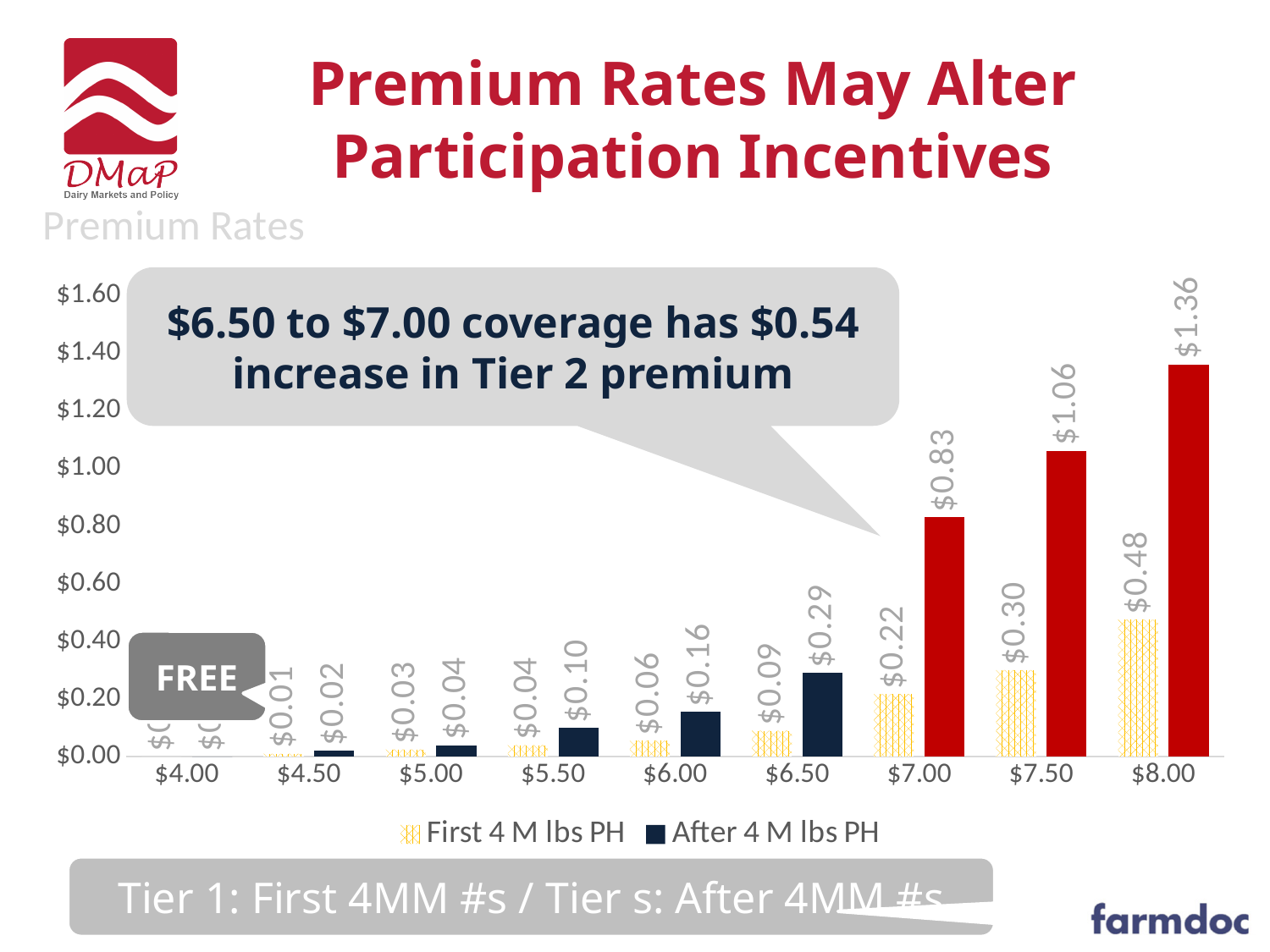
Which is larger at the $7.50 coverage level: First 4 M lbs PH or After 4 M lbs PH? After 4 M lbs PH How many coverage levels are shown on the x axis? 9 What is the value for First 4 M lbs PH at the $7.00 coverage level? $0.22 What is the value for After 4 M lbs PH at the $6.50 coverage level? $0.29 What is the difference between the After 4 M lbs PH premium at $7.00 and at $6.50? $0.54 Do the After 4 M lbs PH premiums rise or fall as the coverage level increases from $4.00 to $8.00? Rise What is the difference between the After 4 M lbs PH and First 4 M lbs PH premiums at $8.00? $0.88 What is the value for First 4 M lbs PH at the $7.50 coverage level? $0.30 Which coverage level has the highest After 4 M lbs PH premium? $8.00 How many series does the legend list? 2 What kind of chart is shown on the slide? Bar chart What is the value for After 4 M lbs PH at the $8.00 coverage level? $1.36